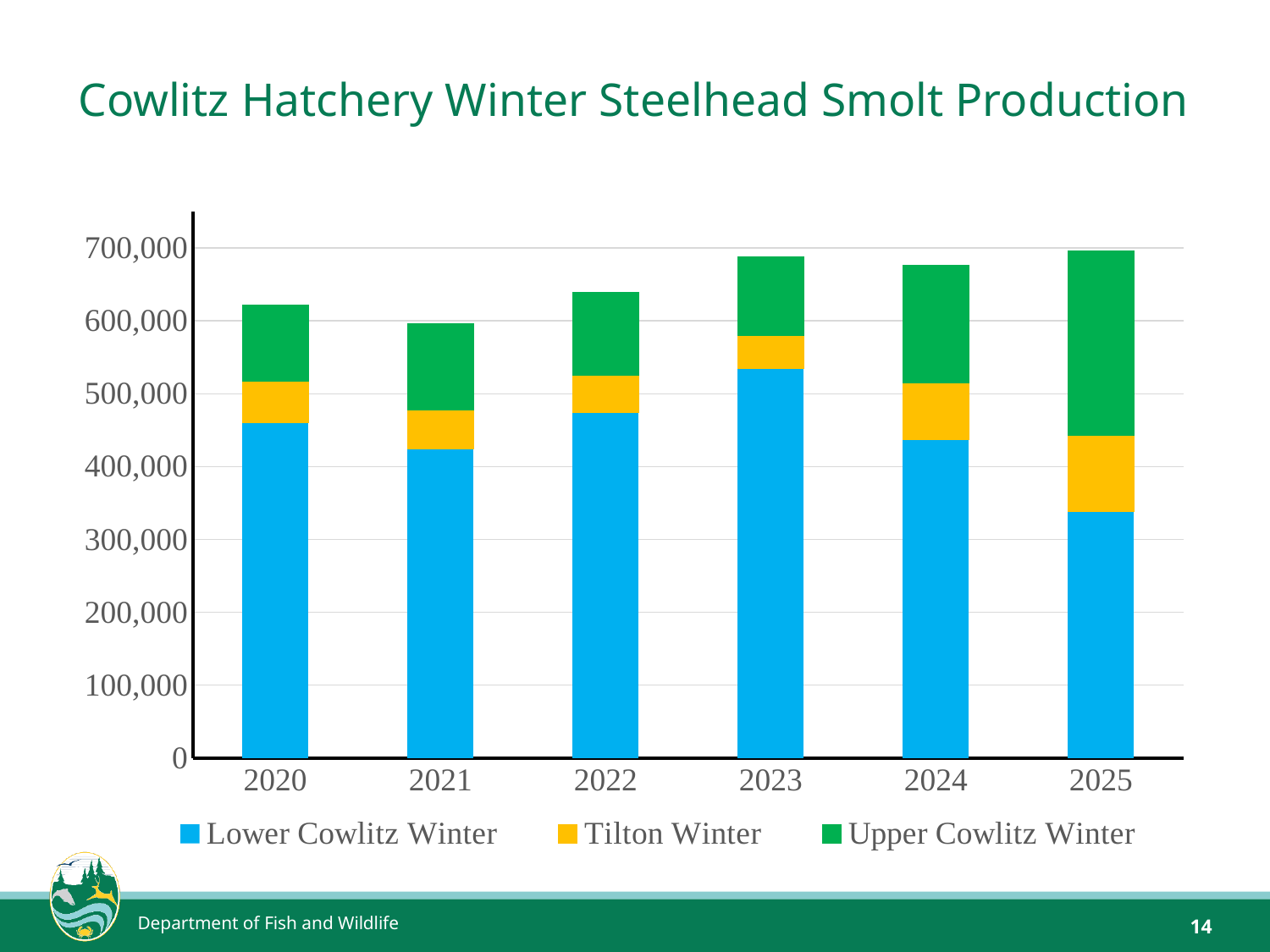
What is the title of the chart? Cowlitz Hatchery Winter Steelhead Smolt Production Is the Lower Cowlitz Winter value for 2025 greater or less than 400,000? less Is the Lower Cowlitz Winter value for 2023 greater or less than 500,000? greater What kind of chart is shown on the slide? Stacked bar chart Which year has the larger Upper Cowlitz Winter segment, 2020 or 2025? 2025 How many series does the chart's legend list? 3 In which year is the Lower Cowlitz Winter segment the smallest? 2025 Is the total smolt production for 2020 greater or less than 600,000? greater In which year is the Lower Cowlitz Winter segment the largest? 2023 Which series is shown in yellow in the chart? Tilton Winter How many years are shown on the x axis of the chart? 6 Which year has the lowest total smolt production? 2021